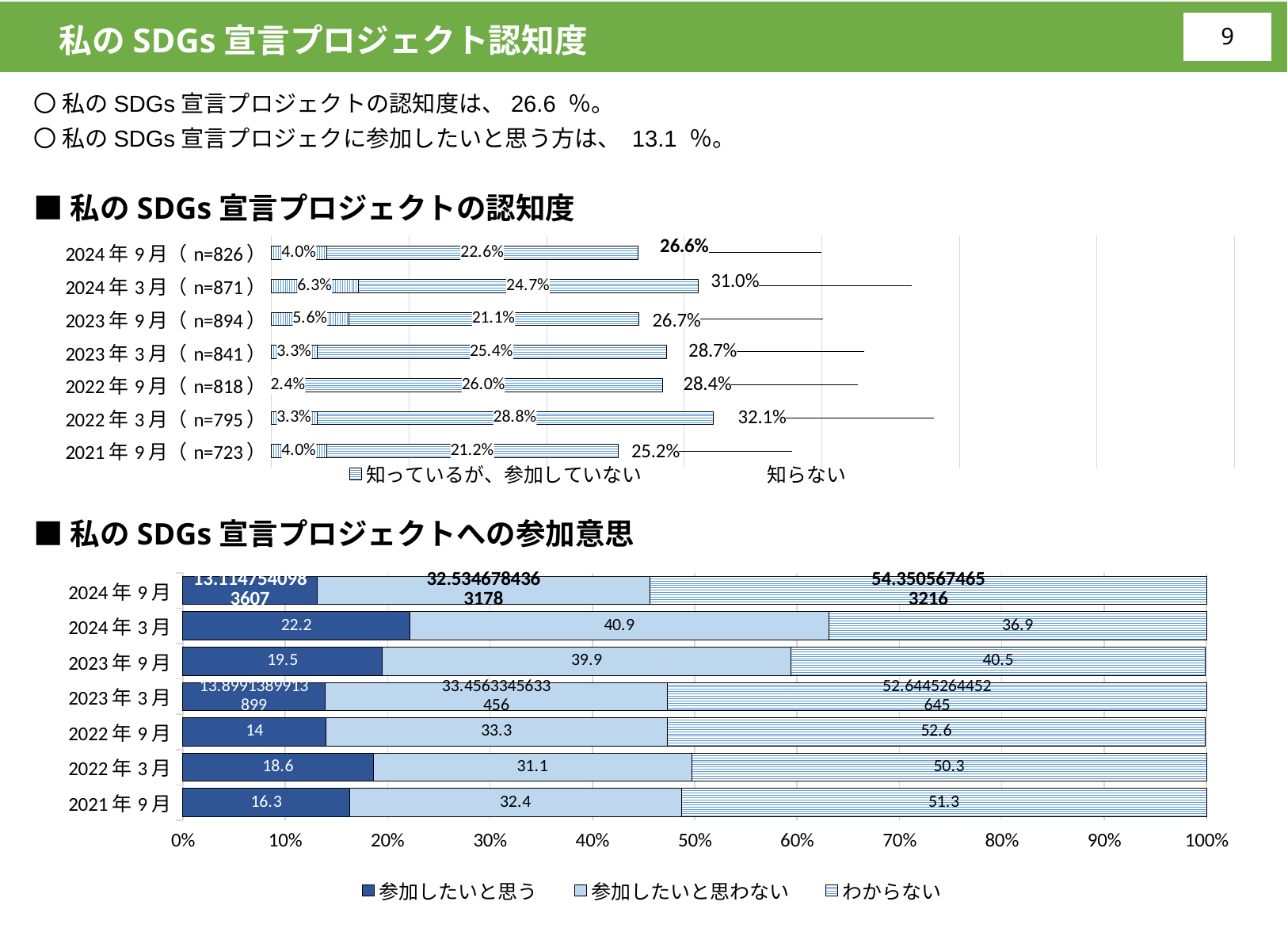
In the bottom chart (私のSDGs宣言プロジェクトへの参加意思), which survey period has the highest value for 参加したいと思う? 2024年3月 How many categories (survey periods) are shown in the bottom chart (私のSDGs宣言プロジェクトへの参加意思)? 7 How many series does the legend of the bottom chart (私のSDGs宣言プロジェクトへの参加意思) list? 3 In the top chart (私のSDGs宣言プロジェクトの認知度), what is the value of 知っているが、参加していない for 2022年3月 (n=795)? 28.8% In the bottom chart (私のSDGs宣言プロジェクトへの参加意思), what is the value of 参加したいと思う for 2024年3月? 22.2 In the bottom chart (私のSDGs宣言プロジェクトへの参加意思), which is larger: わからない for 2023年9月 or わからない for 2022年9月? 2022年9月 In the bottom chart (私のSDGs宣言プロジェクトへの参加意思), what is the value of わからない for 2022年9月? 52.6 In the bottom chart (私のSDGs宣言プロジェクトへの参加意思), what is the difference between 参加したいと思う for 2024年3月 and for 2023年9月? 2.7 In the top chart (私のSDGs宣言プロジェクトの認知度), what is the value of 知っているが、参加していない for 2024年9月 (n=826)? 22.6% What kind of chart is the top chart (私のSDGs宣言プロジェクトの認知度)? bar chart What kind of chart is the bottom chart (私のSDGs宣言プロジェクトへの参加意思)? bar chart In the bottom chart (私のSDGs宣言プロジェクトへの参加意思), what is the value of 参加したいと思わない for 2021年9月? 32.4